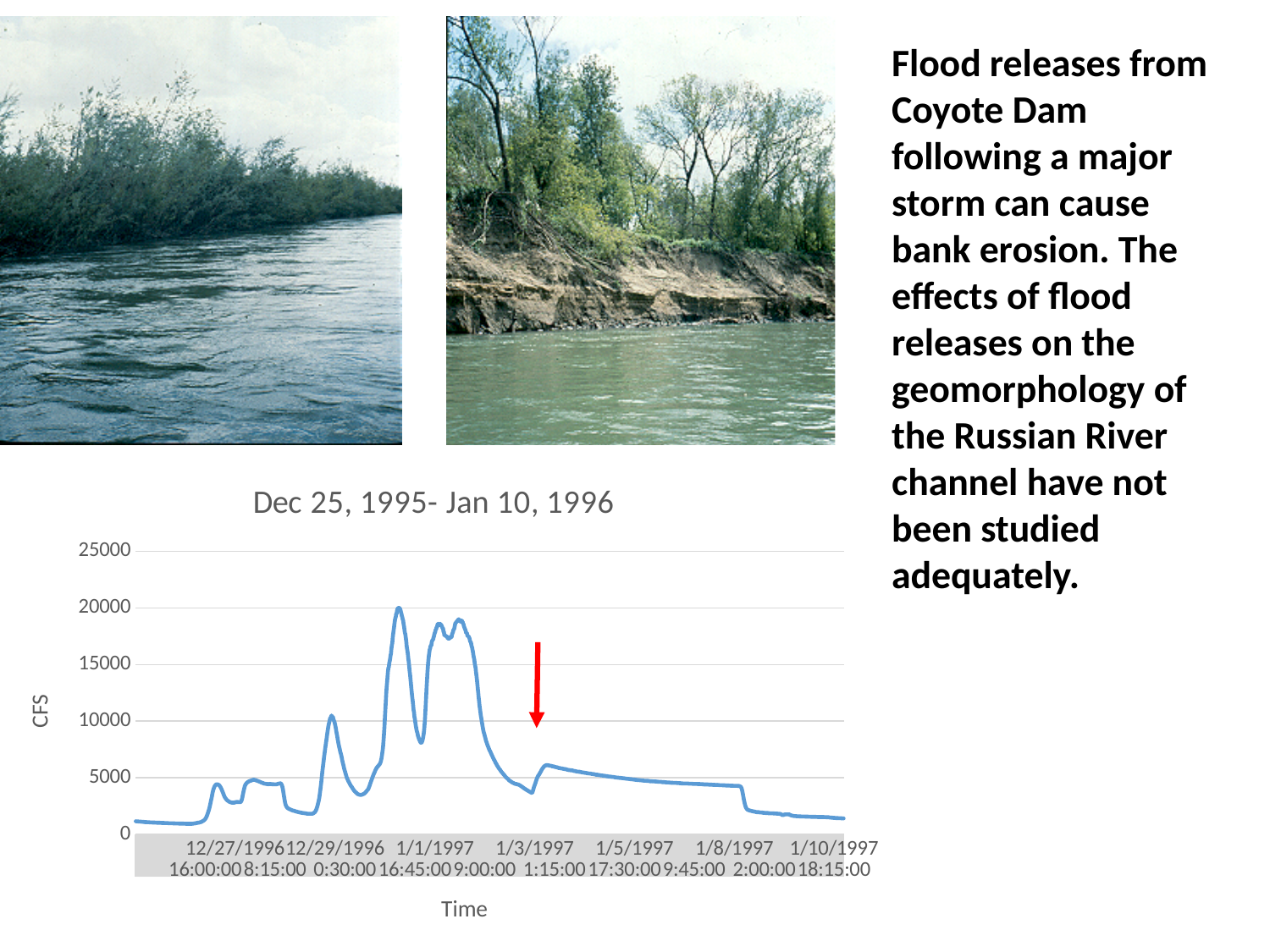
What kind of chart is shown on the slide? line chart Is the highest value reached by the line greater or less than 15000? greater What is the label on the vertical axis of the chart? CFS Which is larger, the value at 1/3/1997 1:15:00 or the value at 1/10/1997 18:15:00? 1/3/1997 1:15:00 How many lines are plotted on the chart? 1 Is the value at 1/5/1997 17:30:00 greater or less than 10000? less What is the title of the chart? Dec 25, 1995- Jan 10, 1996 Is the value at 12/27/1996 16:00:00 greater or less than 5000? less After the peak near 1/1/1997, do the values generally rise or fall toward 1/10/1997? fall